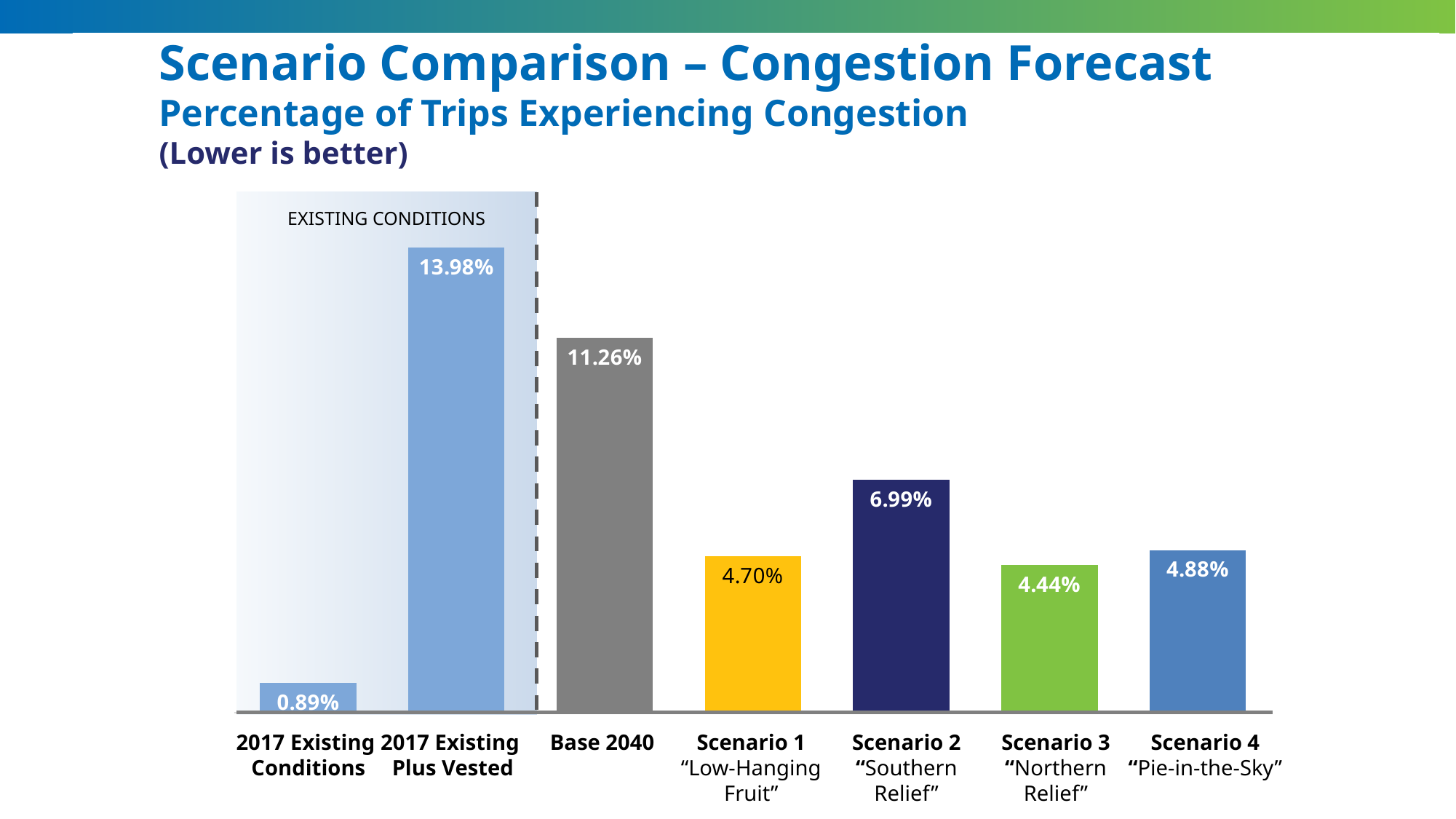
What is the value for Scenario 3 "Northern Relief"? 4.44% Which category has the highest value? 2017 Existing Plus Vested Which category has the lowest value? 2017 Existing Conditions What is the difference between Base 2040 and Scenario 2 "Southern Relief"? 4.27% Which is larger, Scenario 2 "Southern Relief" or Scenario 4 "Pie-in-the-Sky"? Scenario 2 "Southern Relief" What is the value for Base 2040? 11.26% What is the value for Scenario 1 "Low-Hanging Fruit"? 4.70% What is the difference between Scenario 4 "Pie-in-the-Sky" and Scenario 3 "Northern Relief"? 0.44% What is the value for 2017 Existing Plus Vested? 13.98% What kind of chart is shown on the slide? Bar chart How many categories are shown in the chart? 7 Which two categories are grouped under the label "EXISTING CONDITIONS"? 2017 Existing Conditions and 2017 Existing Plus Vested